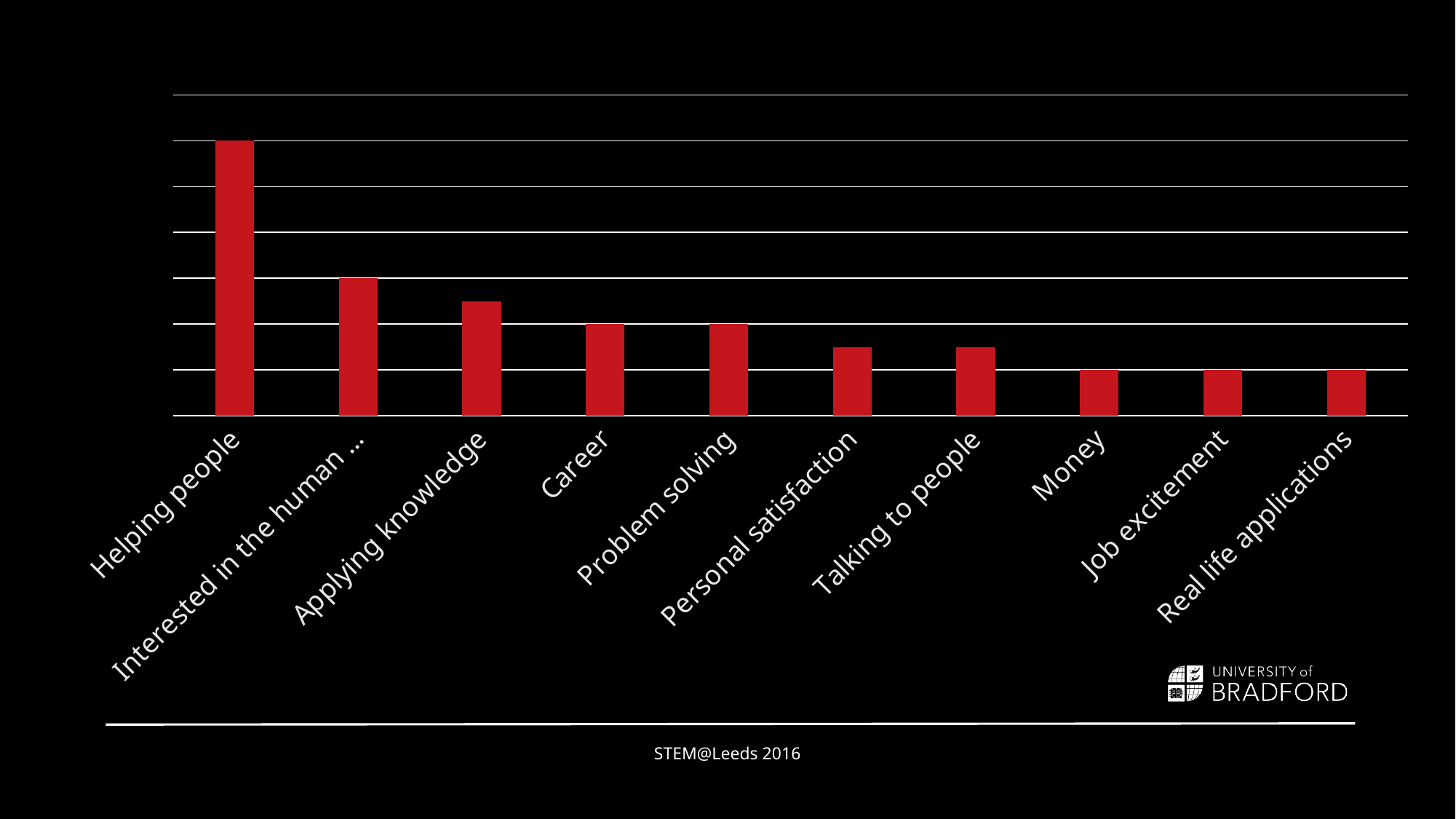
Which is larger, the value for Talking to people or the value for Job excitement? Talking to people What is the label of the first category on the left of the x axis? Helping people What colour are the bars in the chart? red Which is larger, the value for Personal satisfaction or the value for Money? Personal satisfaction Which is larger, the value for Applying knowledge or the value for Career? Applying knowledge Which category has the highest bar? Helping people Do the bar values generally rise or fall from left to right along the x axis? fall How many categories are plotted on the chart? 10 What kind of chart is shown on the slide? bar chart